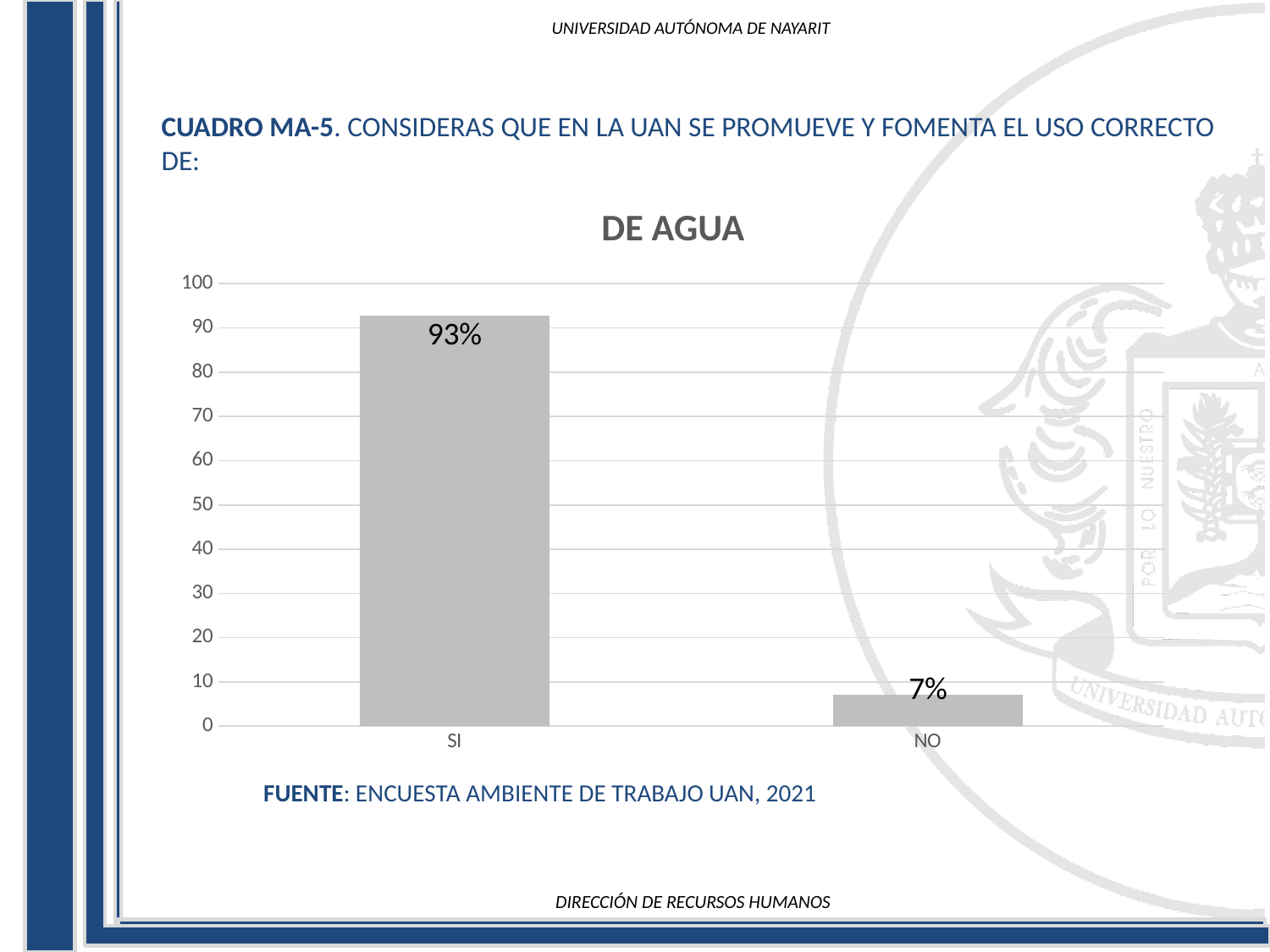
Which category has the lowest value? NO Is the value for NO greater or less than 10? less What is the difference between the values for SI and NO? 86% Which category has the highest value? SI What is the value for SI? 93% What is the value for NO? 7% What is the title of the chart? DE AGUA Which is larger, the value for SI or the value for NO? SI How many categories are shown on the x axis? 2 Is the value for SI greater or less than 90? greater What kind of chart is shown? bar chart What is the maximum value shown on the y axis? 100